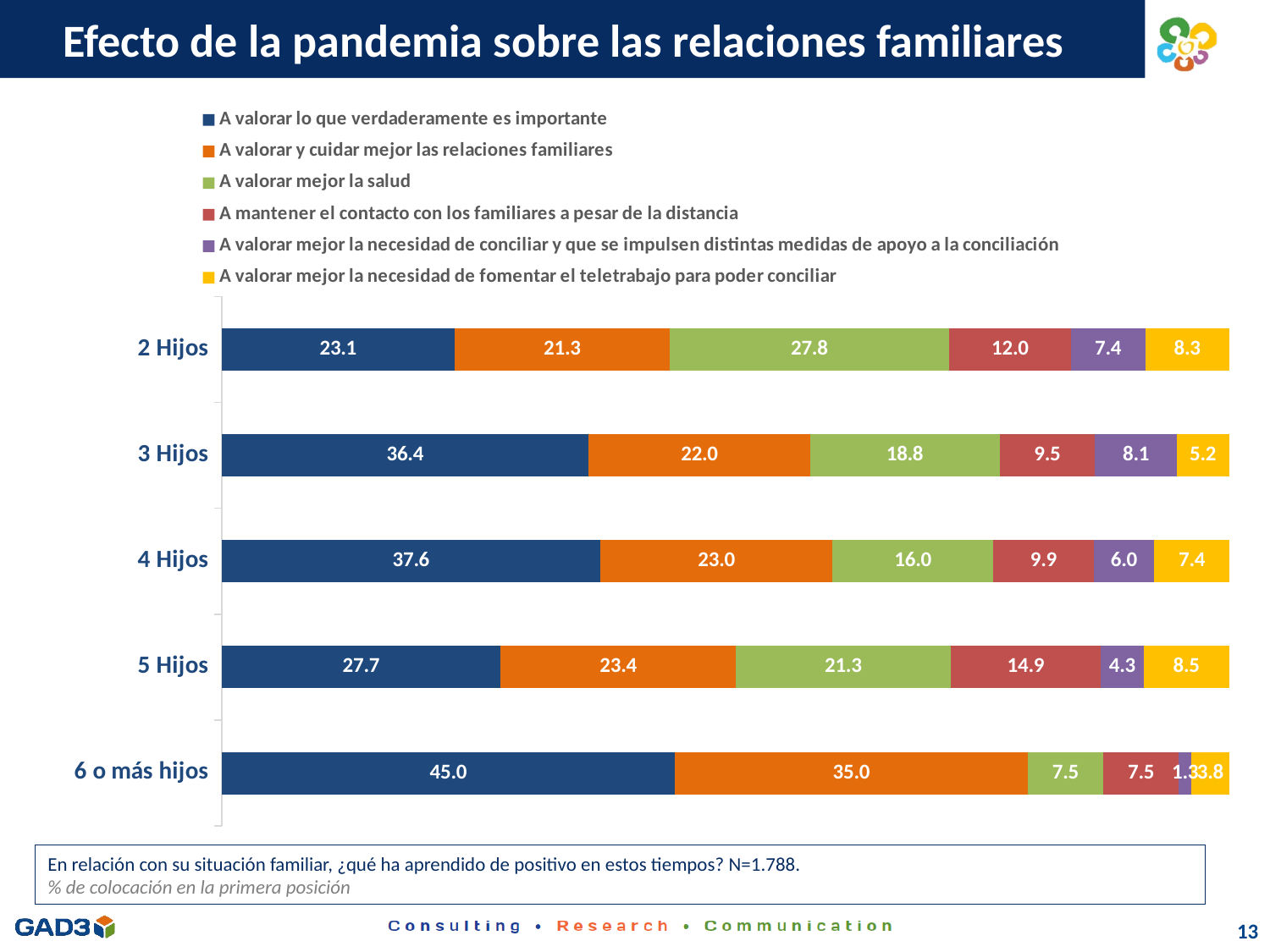
How many categories (family sizes) are shown on the chart? 5 Which category has the highest value for 'A valorar lo que verdaderamente es importante'? 6 o más hijos How many series does the legend list? 6 What is the value for 'A mantener el contacto con los familiares a pesar de la distancia' for 5 Hijos? 14.9 What kind of chart is shown on the slide? Stacked bar chart What is the value for 'A valorar mejor la salud' for 2 Hijos? 27.8 What is the value for 'A valorar lo que verdaderamente es importante' for 6 o más hijos? 45.0 What is the difference between the 'A valorar lo que verdaderamente es importante' values for 4 Hijos and 2 Hijos? 14.5 Which colour represents 'A valorar mejor la necesidad de fomentar el teletrabajo para poder conciliar' in the legend? Yellow Which category has the lowest value for 'A valorar y cuidar mejor las relaciones familiares'? 2 Hijos What is the total of the stacked bar for 3 Hijos? 100.0 Which is larger for 3 Hijos: 'A valorar mejor la salud' or 'A valorar y cuidar mejor las relaciones familiares'? A valorar y cuidar mejor las relaciones familiares